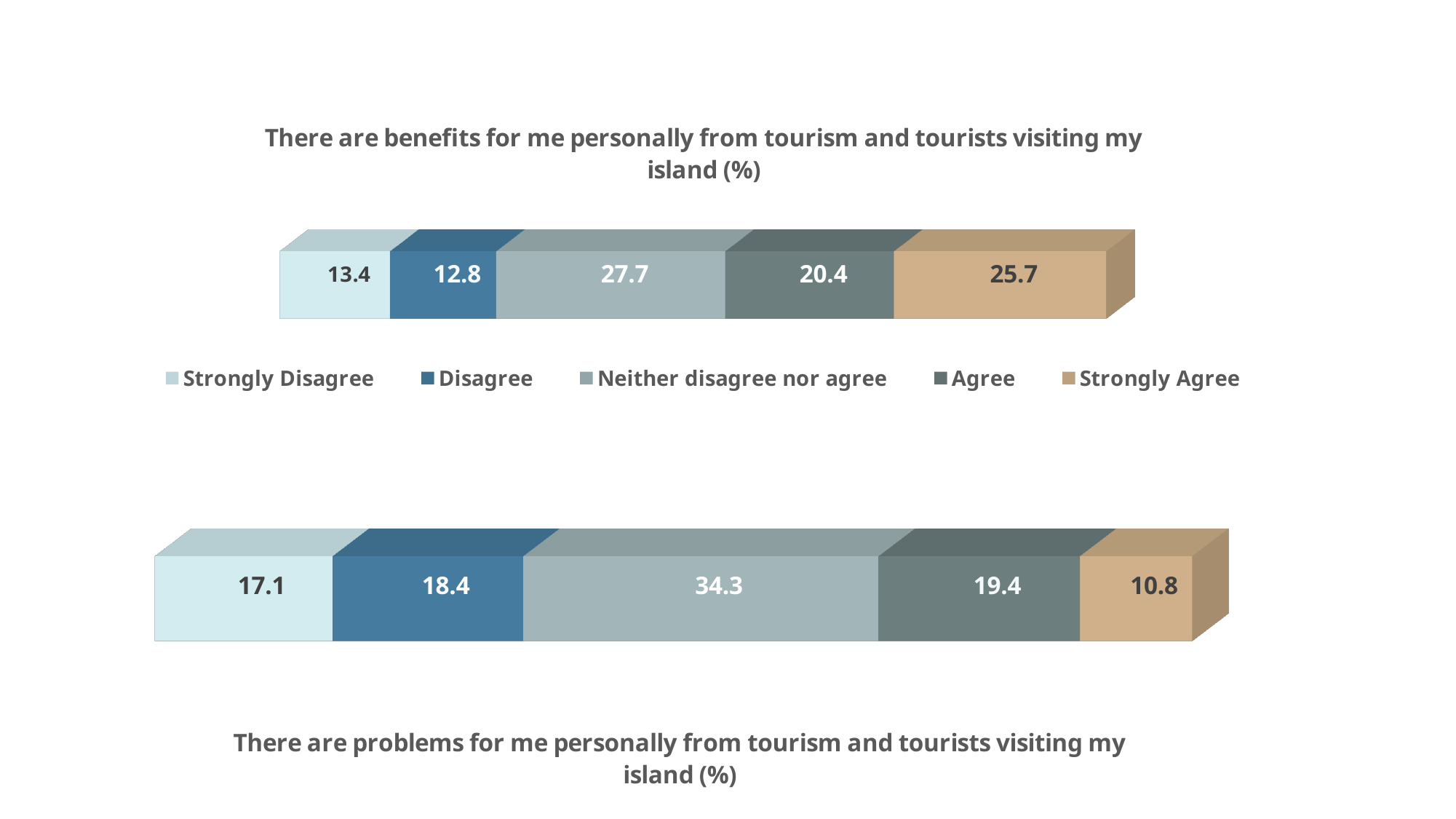
What is the total of the stacked bar in the 'There are problems for me personally from tourism and tourists visiting my island (%)' chart? 100.0 In the 'There are problems for me personally from tourism and tourists visiting my island (%)' chart, which response category has the highest value? Neither disagree nor agree In the 'There are benefits for me personally from tourism and tourists visiting my island (%)' chart, what is the difference between Strongly Agree and Strongly Disagree? 12.3 How many series does the legend list? 5 In the 'There are problems for me personally from tourism and tourists visiting my island (%)' chart, which is larger, Agree or Strongly Agree? Agree In the 'There are benefits for me personally from tourism and tourists visiting my island (%)' chart, what is the value for Neither disagree nor agree? 27.7 In the 'There are problems for me personally from tourism and tourists visiting my island (%)' chart, what is the value for Strongly Agree? 10.8 In the 'There are problems for me personally from tourism and tourists visiting my island (%)' chart, what is the value for Disagree? 18.4 Which legend entry is shown in the tan/brown colour? Strongly Agree In the 'There are benefits for me personally from tourism and tourists visiting my island (%)' chart, which response category has the lowest value? Disagree What kind of chart is the 'There are benefits for me personally from tourism and tourists visiting my island (%)' chart? Stacked bar chart In the 'There are benefits for me personally from tourism and tourists visiting my island (%)' chart, what is the value for Strongly Agree? 25.7